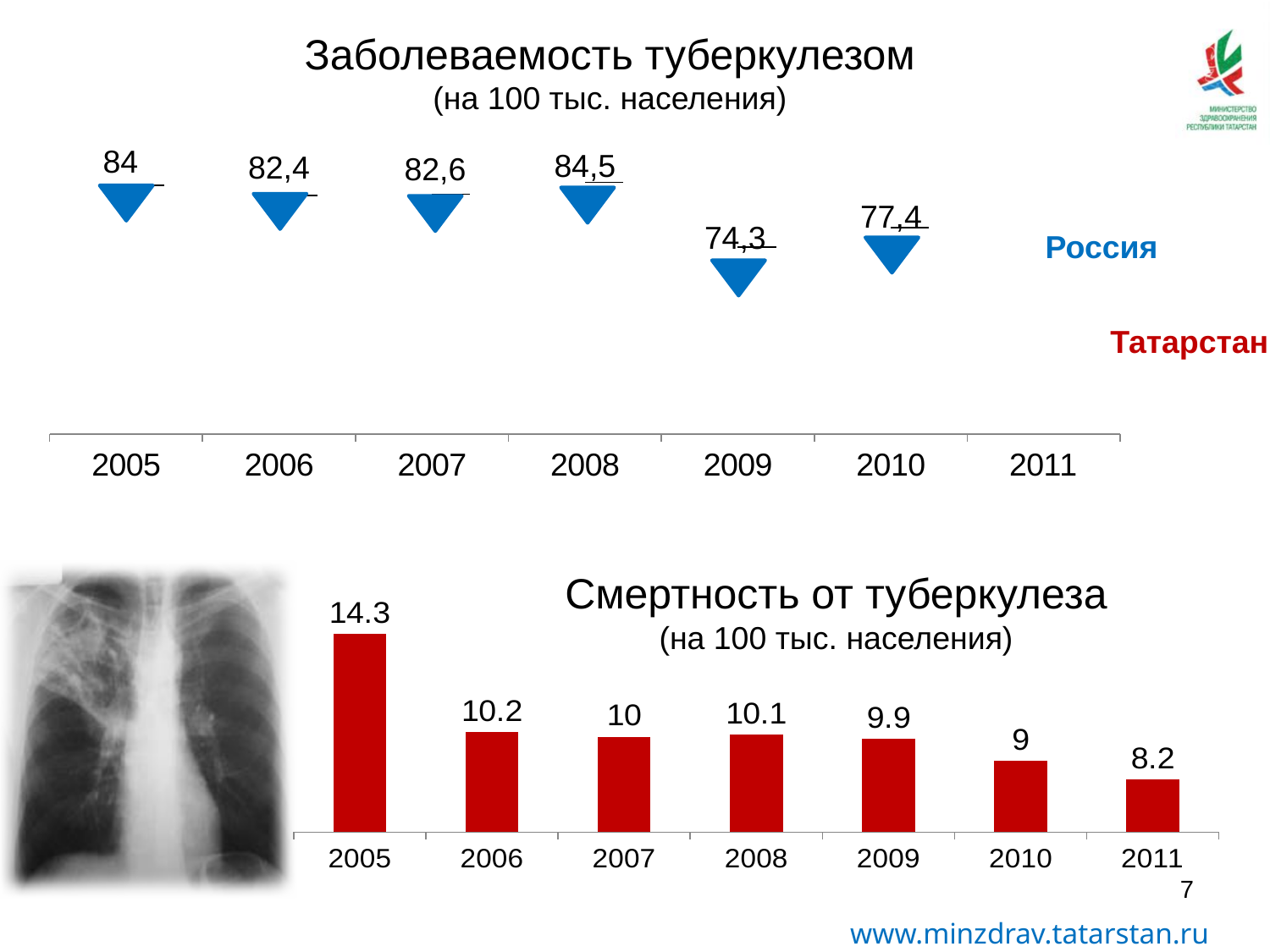
In the 'Заболеваемость туберкулезом' chart, which two series are named in the legend? Россия and Татарстан In the 'Смертность от туберкулеза' chart, what is the difference between the 2005 and 2006 values? 4.1 In the 'Заболеваемость туберкулезом' chart, what is the Россия value for 2008? 84,5 In the 'Смертность от туберкулеза' chart, what is the value for 2011? 8.2 In the 'Заболеваемость туберкулезом' chart, which is larger for Россия: the 2009 value or the 2010 value? 2010 What kind of chart is the 'Смертность от туберкулеза' chart? bar chart In the 'Смертность от туберкулеза' chart, do the values generally rise or fall from 2005 to 2011? fall In the 'Заболеваемость туберкулезом' chart, what is the Россия value for 2009? 74,3 In the 'Смертность от туберкулеза' chart, what is the value for 2005? 14.3 In the 'Смертность от туберкулеза' chart, which year has the highest value? 2005 In the 'Смертность от туберкулеза' chart, which year has the lowest value? 2011 In the 'Смертность от туберкулеза' chart, how many years are shown on the x axis? 7